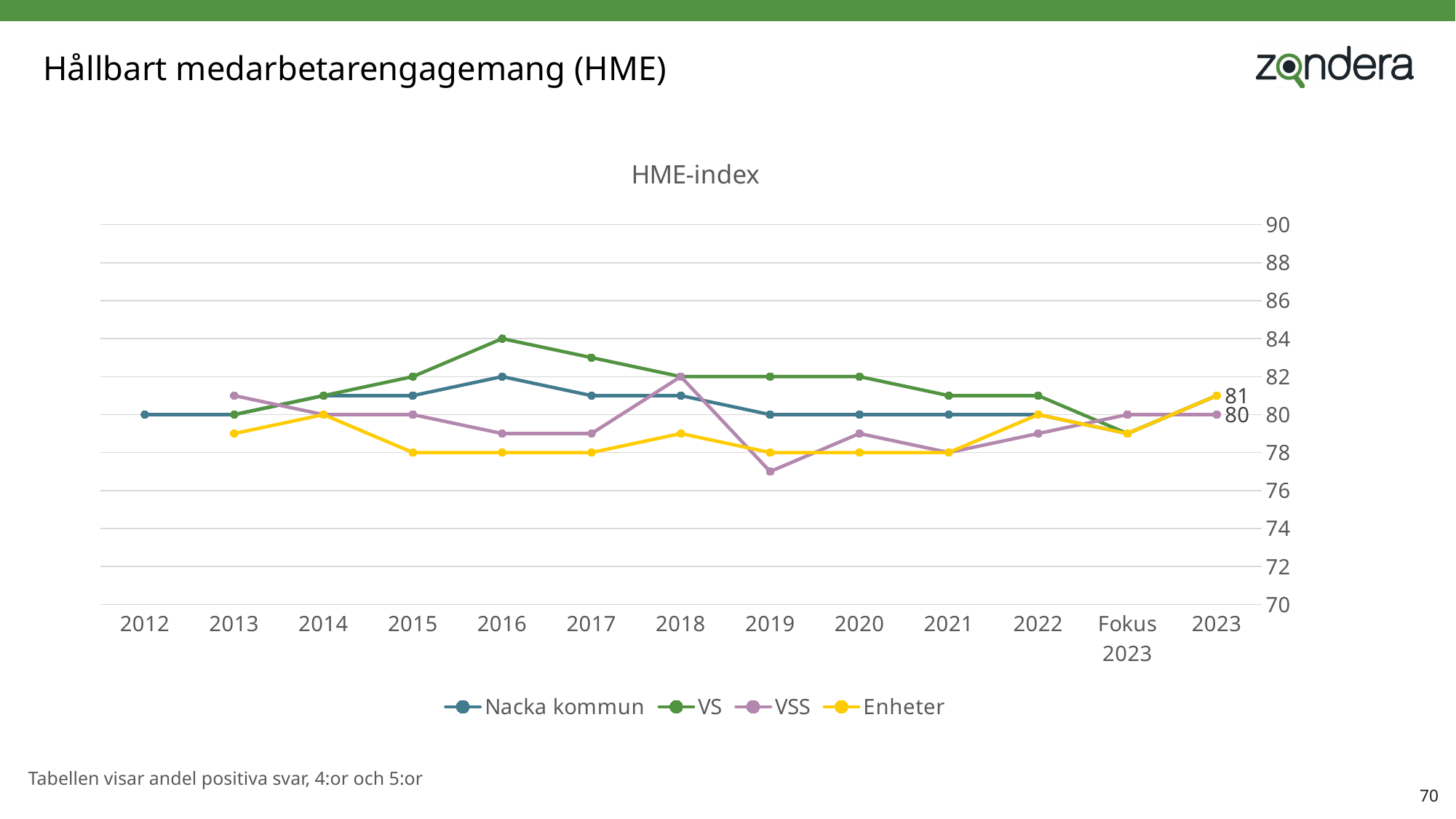
In which year does the VS series reach its highest value? 2016 In 2016, which is larger: VS or Nacka kommun? VS How many series does the legend of the HME-index chart list? 4 What kind of chart is shown on the slide? line chart In which year does the VSS series reach its lowest value? 2019 How many points are there along the x axis of the HME-index chart? 13 What is the value for Enheter in 2023? 81 What is the difference between Enheter and VSS in 2023? 1 What is the value for VS in 2016? 84 Is the value for VSS in 2019 greater or less than 78? less Does the VS series rise or fall from 2016 to 2019? fall What is the value for VSS in 2023? 80